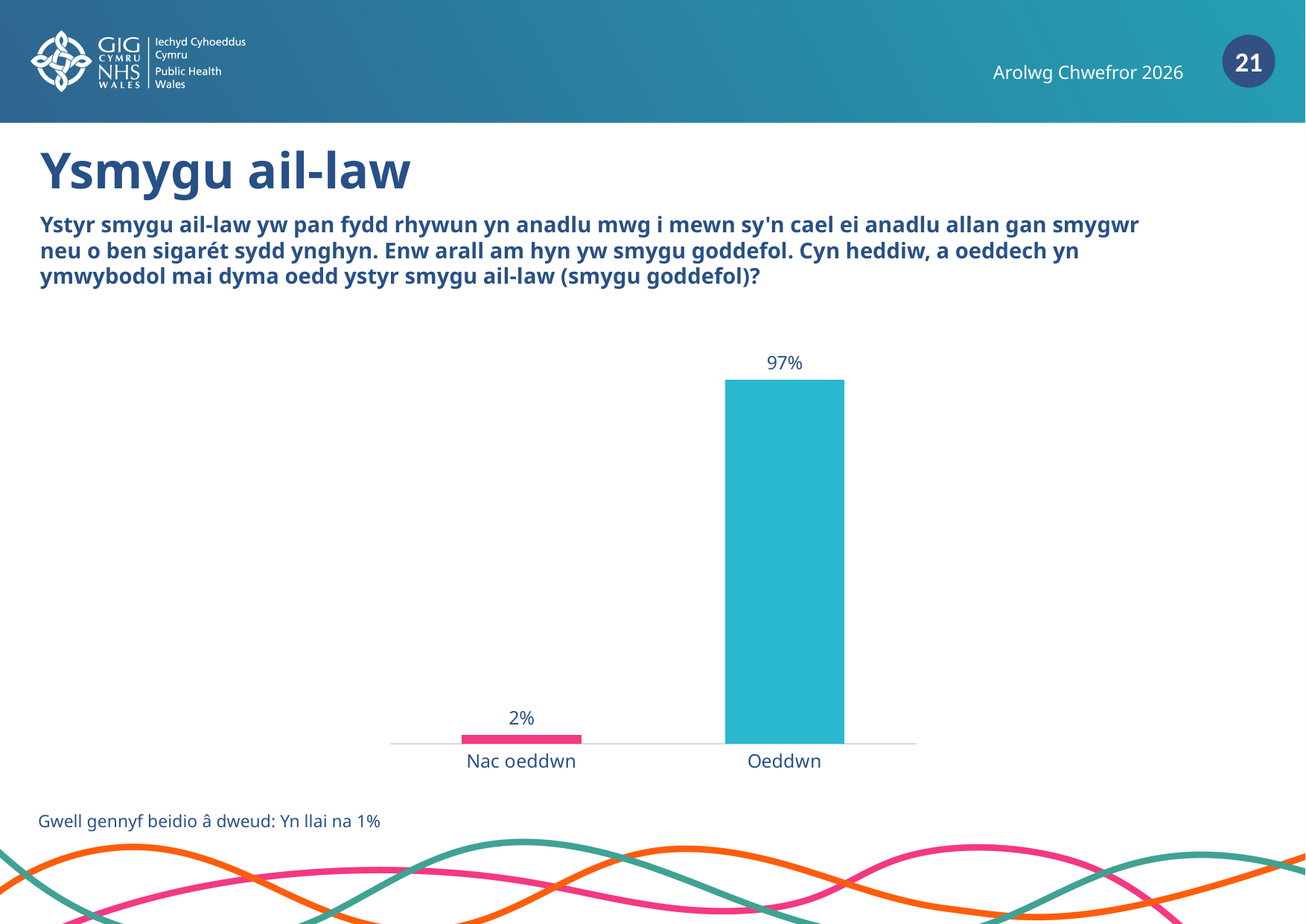
Which category has the lowest value? Nac oeddwn What colour is the bar for Oeddwn? Teal/blue Which category has the highest value? Oeddwn What is the value for Nac oeddwn? 2% Which is larger, the value for Oeddwn or the value for Nac oeddwn? Oeddwn What kind of chart is shown on the slide? Bar chart What is the difference between the values for Oeddwn and Nac oeddwn? 95% How many categories are shown on the chart? 2 What is the value for Oeddwn? 97% Do the values rise or fall from left to right along the x axis? Rise What colour is the bar for Nac oeddwn? Pink